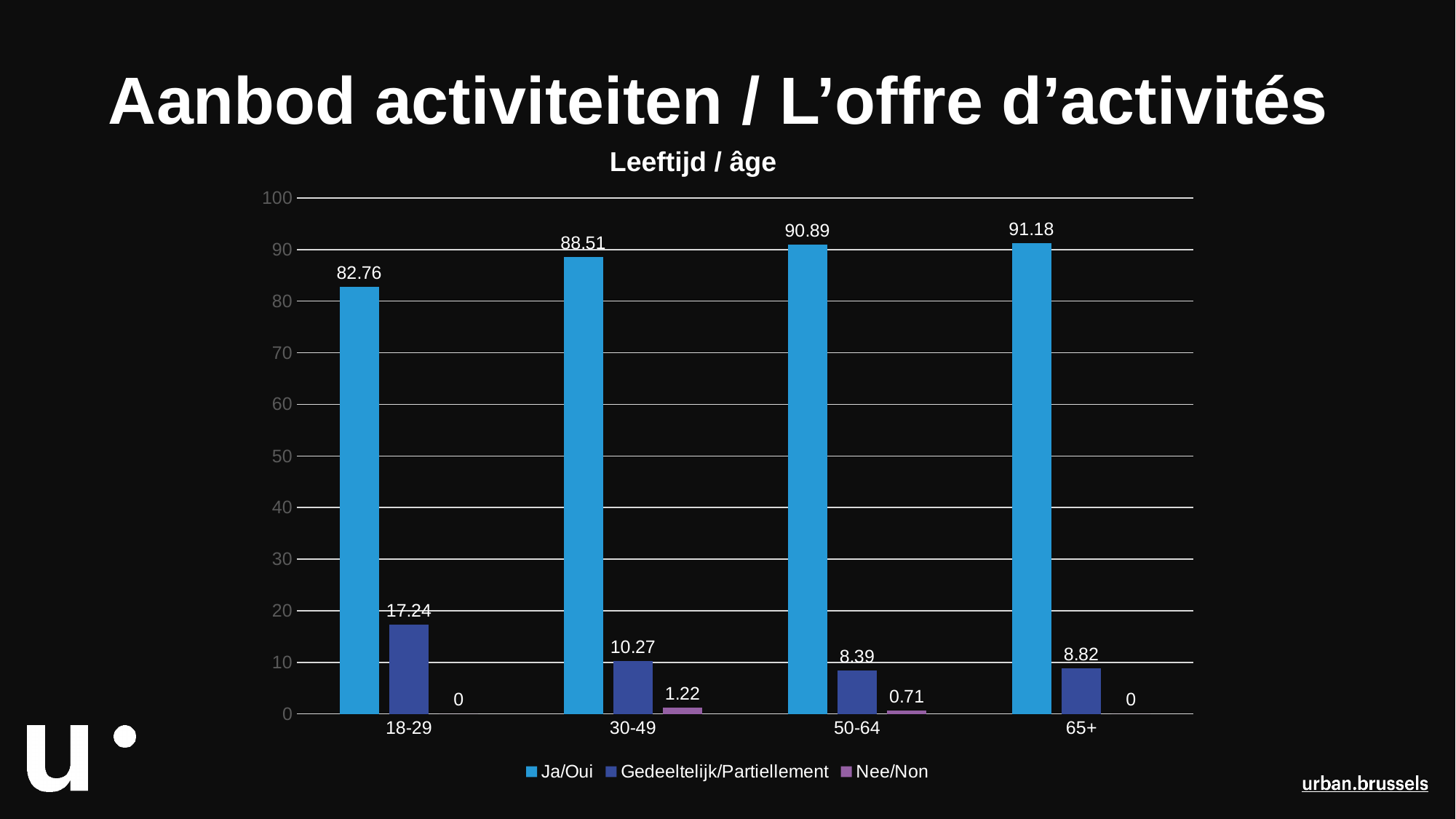
What kind of chart is shown on the slide? bar chart Which age group has the lowest Ja/Oui value? 18-29 What is the Nee/Non value for the 50-64 age group? 0.71 Which age group has the highest Ja/Oui value? 65+ Which is larger, the Gedeeltelijk/Partiellement value for 18-29 or for 65+? 18-29 What is the difference between the Ja/Oui values for 65+ and 18-29? 8.42 What is the Ja/Oui value for the 18-29 age group? 82.76 Is the Ja/Oui value for 30-49 greater or less than 80? greater Do the Ja/Oui values rise or fall from the 18-29 group to the 65+ group? rise How many series does the legend list? 3 What is the Gedeeltelijk/Partiellement value for the 30-49 age group? 10.27 How many age groups are shown on the x axis? 4